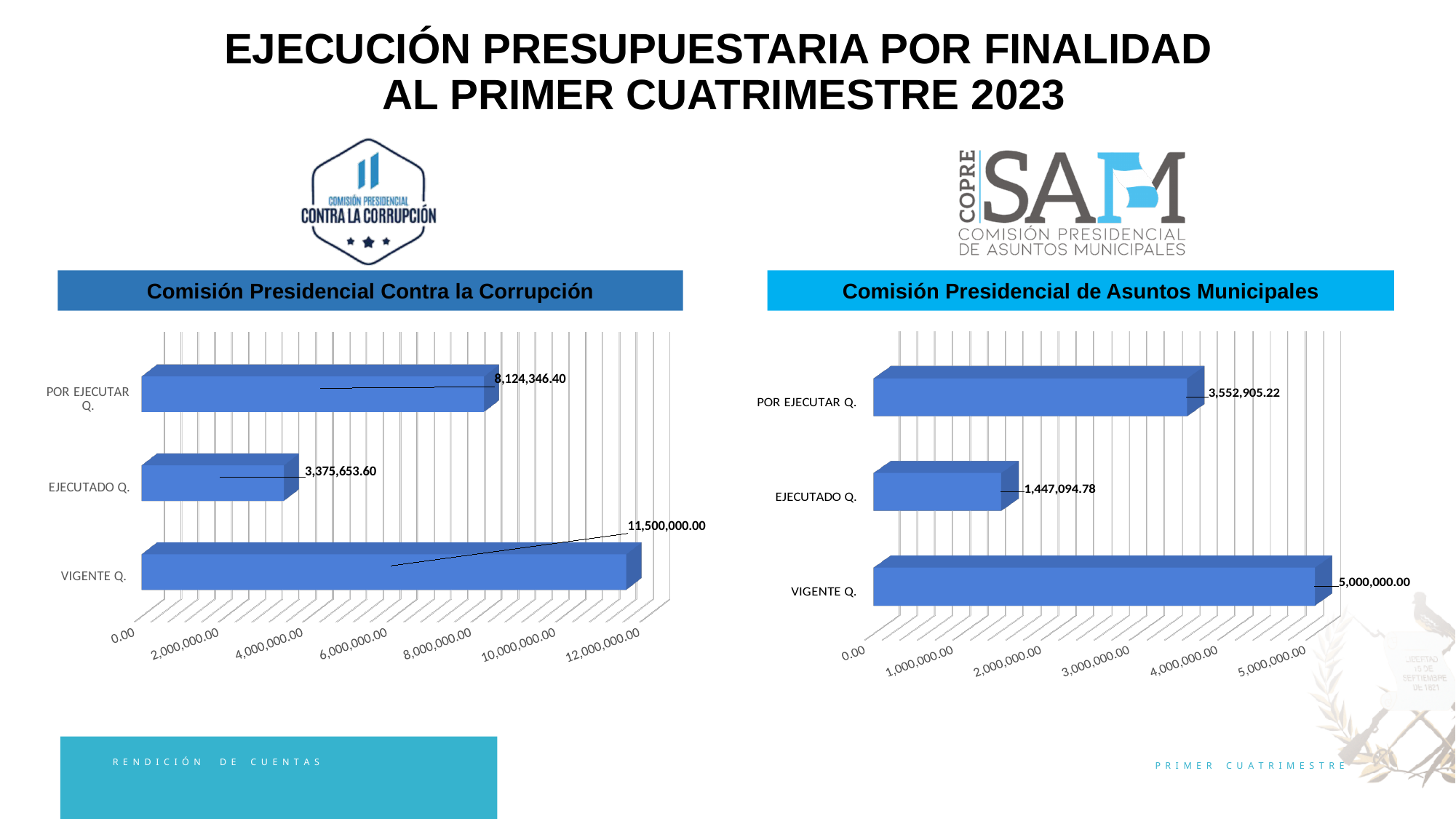
In the Comisión Presidencial de Asuntos Municipales chart, what is the difference between POR EJECUTAR Q. and EJECUTADO Q.? 2,105,810.44 In the Comisión Presidencial Contra la Corrupción chart, is the value for EJECUTADO Q. greater or less than 4,000,000.00? less In the Comisión Presidencial Contra la Corrupción chart, what is the value for POR EJECUTAR Q.? 8,124,346.40 What kind of chart is the Comisión Presidencial Contra la Corrupción chart? bar chart In the Comisión Presidencial Contra la Corrupción chart, what is the difference between POR EJECUTAR Q. and EJECUTADO Q.? 4,748,692.80 In the Comisión Presidencial Contra la Corrupción chart, what is the value for EJECUTADO Q.? 3,375,653.60 How many categories are shown in the Comisión Presidencial de Asuntos Municipales chart? 3 In the Comisión Presidencial de Asuntos Municipales chart, what is the value for EJECUTADO Q.? 1,447,094.78 In the Comisión Presidencial Contra la Corrupción chart, which category has the highest value? VIGENTE Q. In the Comisión Presidencial de Asuntos Municipales chart, which category has the lowest value? EJECUTADO Q. In the Comisión Presidencial de Asuntos Municipales chart, what is the value for VIGENTE Q.? 5,000,000.00 In the Comisión Presidencial de Asuntos Municipales chart, which is larger, POR EJECUTAR Q. or EJECUTADO Q.? POR EJECUTAR Q.